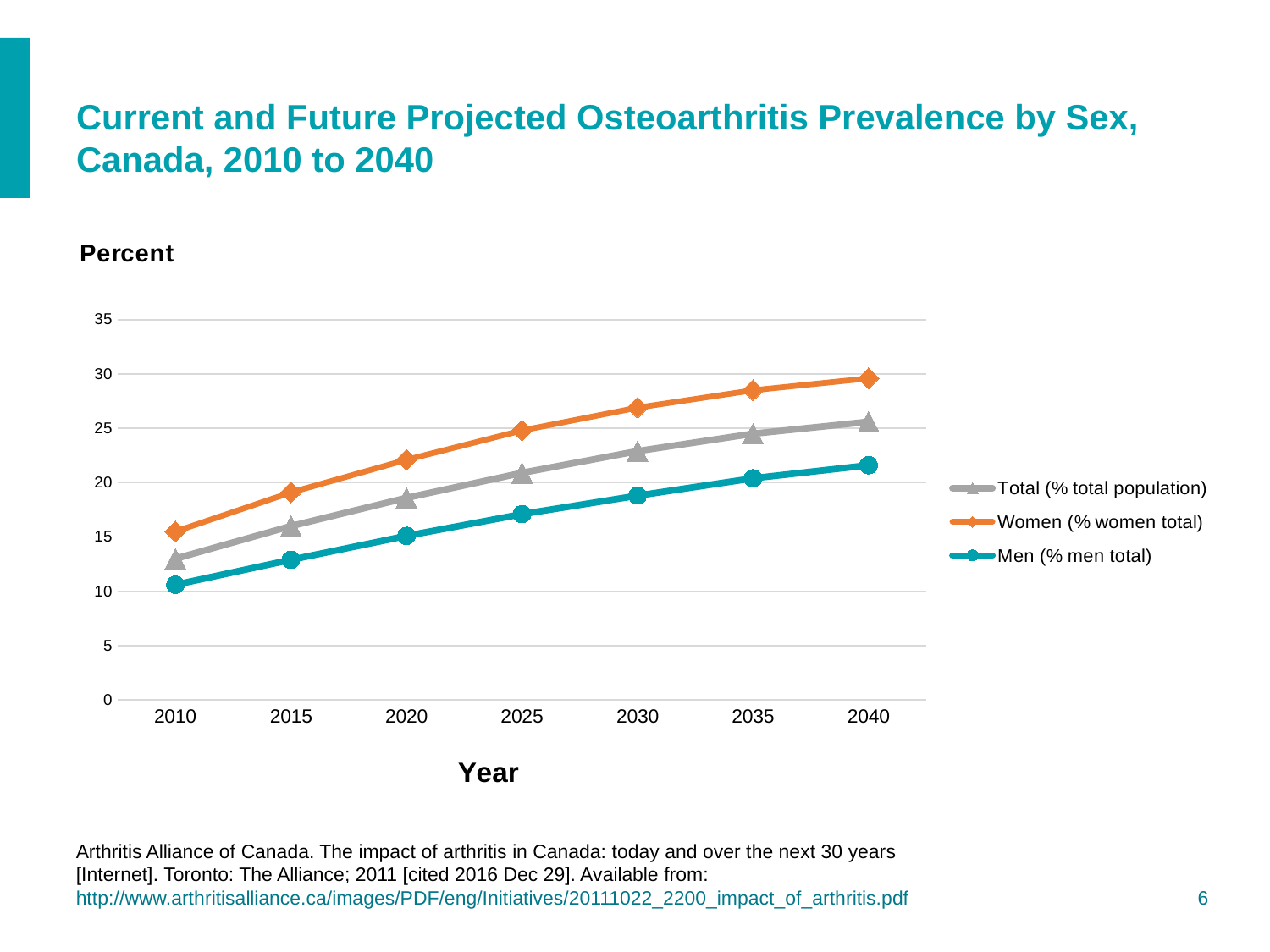
Is the value for Men (% men total) in 2010 greater or less than 15? less What is the label on the x axis of the chart? Year How many series does the legend list? 3 How many years are plotted along the x axis? 7 What kind of chart is shown on the slide? line chart Which series has the lowest values across all years? Men (% men total) Is the value for Women (% women total) in 2040 greater or less than 25? greater Is the value for Women (% women total) in 2020 greater or less than 20? greater Which series has the highest values across all years? Women (% women total) In 2025, which is larger: the value for Women (% women total) or Men (% men total)? Women (% women total) Do the values for Total (% total population) rise or fall from 2010 to 2040? rise